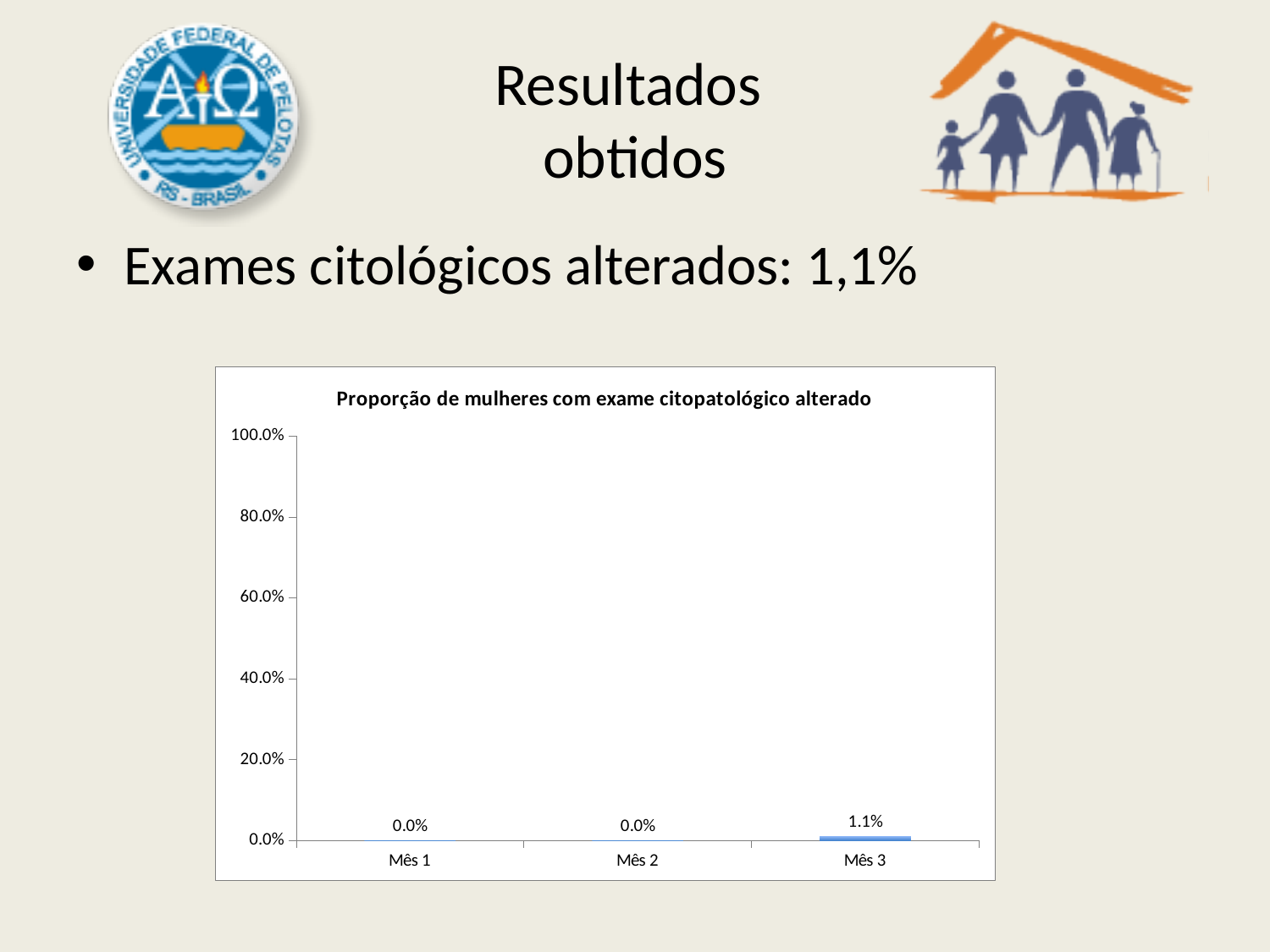
Which is larger, the value for Mês 3 or the value for Mês 2? Mês 3 What kind of chart is shown? bar chart What is the title of the chart? Proporção de mulheres com exame citopatológico alterado Which month has the highest value? Mês 3 Is the value for Mês 3 greater or less than 20.0%? less What is the value for Mês 1? 0.0% What is the value for Mês 3? 1.1% What is the highest value shown on the y axis? 100.0% How many months are shown on the x axis? 3 Do the values rise or fall from Mês 1 to Mês 3? rise What is the difference between the values for Mês 3 and Mês 1? 1.1% What is the value for Mês 2? 0.0%